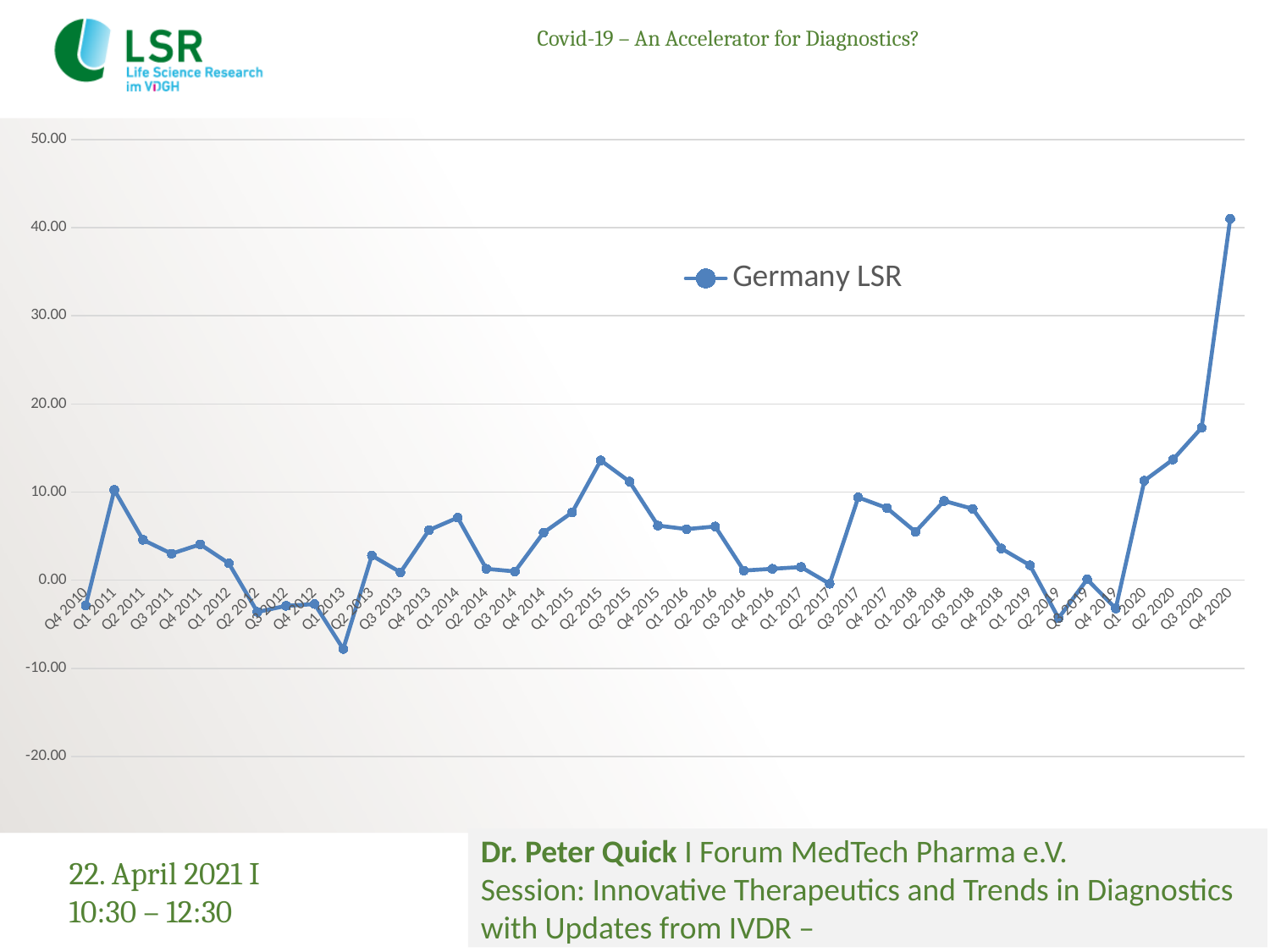
What is the name of the series shown in the legend? Germany LSR Is the value for Q3 2020 greater or less than 20.00? less Which quarter has the lowest value for Germany LSR? Q1 2013 Which is larger, the value for Q4 2020 or the value for Q2 2015? Q4 2020 Do the values rise or fall from Q1 2020 to Q4 2020? Rise Which is larger, the value for Q3 2020 or the value for Q2 2020? Q3 2020 Which quarter has the highest value for Germany LSR? Q4 2020 What kind of chart is shown on the slide? Line chart Is the value for Q4 2020 greater or less than 30.00? greater Is the value for Q2 2013 greater or less than 0.00? greater How many quarterly data points are plotted on the chart? 41 How many series does the legend list? 1